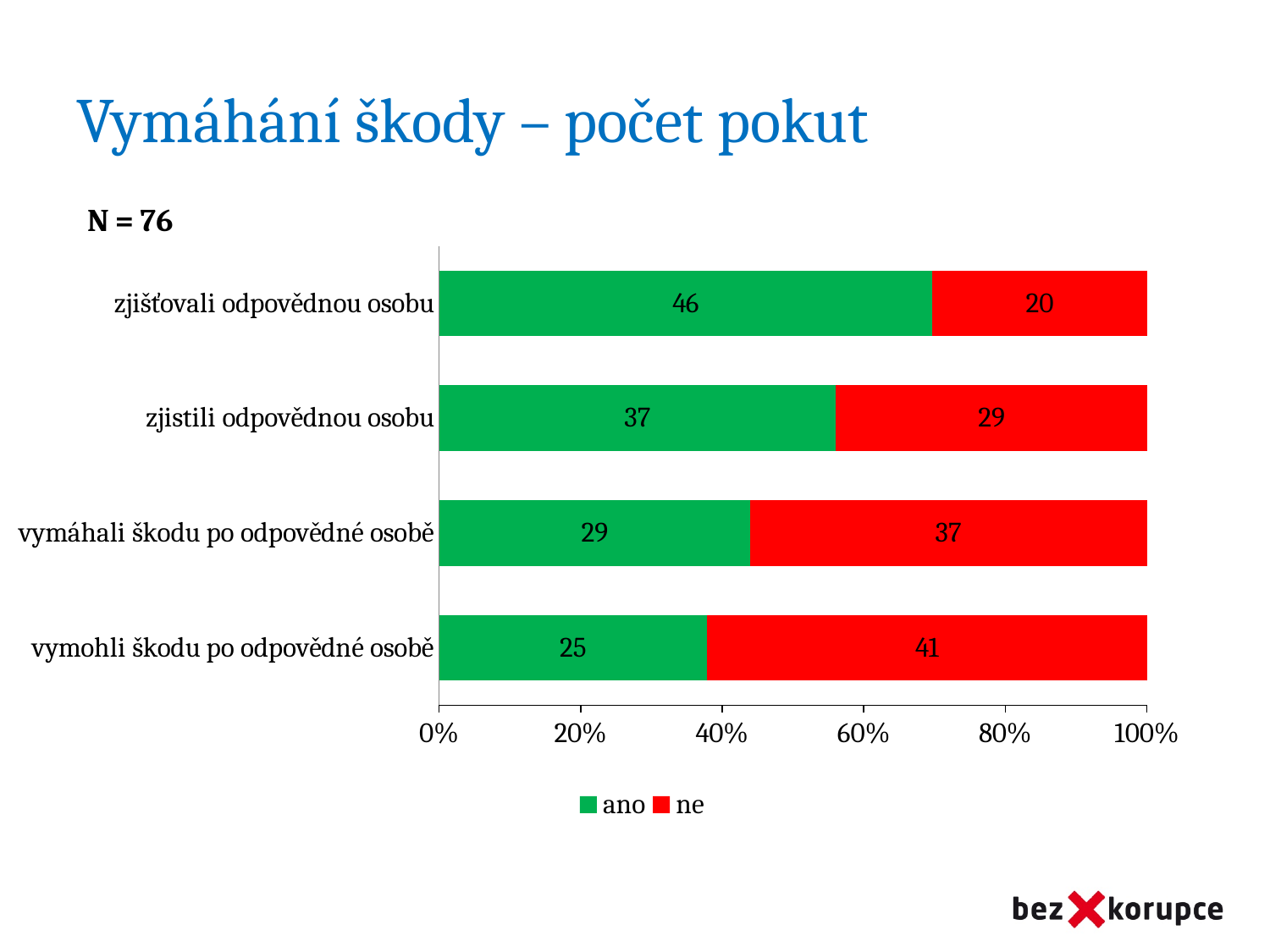
Which category has the lowest "ano" value? vymohli škodu po odpovědné osobě Which is larger for "zjistili odpovědnou osobu": the "ano" value or the "ne" value? ano What is the difference between the "ano" and "ne" values for "vymáhali škodu po odpovědné osobě"? 8 What is the value for "ne" in the "vymohli škodu po odpovědné osobě" bar? 41 How many categories are shown on the chart? 4 How many series does the legend list? 2 What colour represents the "ne" series? red What kind of chart is shown on the slide? stacked bar chart Which category has the highest "ano" value? zjišťovali odpovědnou osobu What is the total of the "ano" and "ne" values for "zjišťovali odpovědnou osobu"? 66 What is the value for "ano" in the "zjišťovali odpovědnou osobu" bar? 46 What is the value for "ne" in the "zjistili odpovědnou osobu" bar? 29